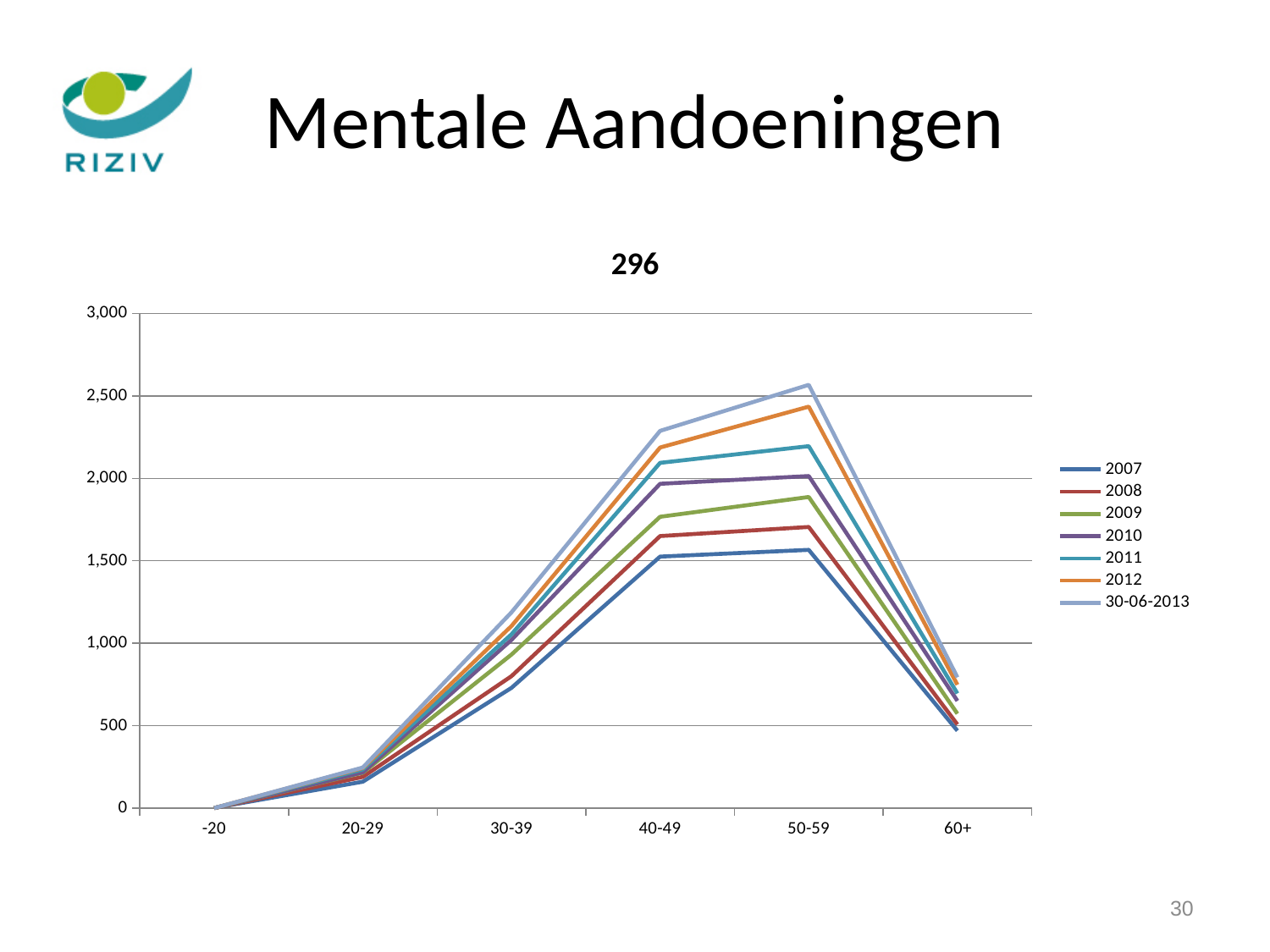
For the 2007 series, which age category has the highest value? 50-59 What kind of chart is shown on the slide? line chart Is the value for 30-06-2013 at 50-59 greater or less than 2,500? greater How many age categories are shown on the x axis? 6 Do the values for the 2012 series rise or fall from 50-59 to 60+? fall How many series does the legend list? 7 Is the value for 2007 at 60+ greater or less than 500? less For the 30-06-2013 series, which age category has the lowest value? -20 At 50-59, which series has the larger value, 2007 or 30-06-2013? 30-06-2013 Which legend entry is listed last? 30-06-2013 What is the title of the chart? 296 Is the value for 2012 at 40-49 greater or less than 2,000? greater